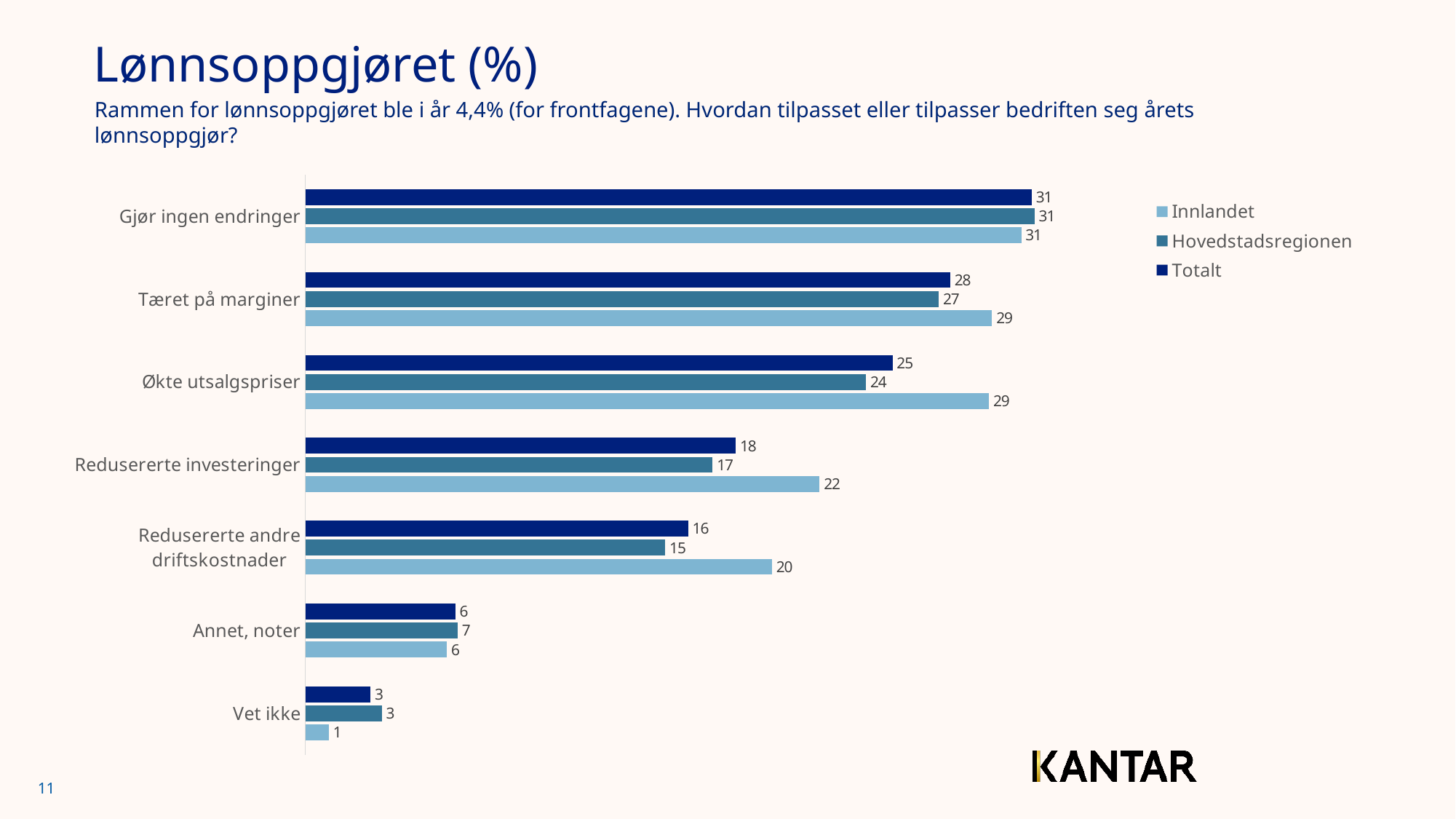
For Reduserte andre driftskostnader, which is larger: the Innlandet value or the Totalt value? Innlandet What is the Innlandet value for Vet ikke? 1 How many series does the legend list? 3 How many categories are shown on the chart? 7 Which series is shown in the darkest blue colour? Totalt Which category has the lowest Innlandet value? Vet ikke What is the difference between the Innlandet and Hovedstadsregionen values for Økte utsalgspriser? 5 What is the Hovedstadsregionen value for Tæret på marginer? 27 What kind of chart is shown on the slide? Bar chart What is the Totalt value for Økte utsalgspriser? 25 What is the Innlandet value for Reduserte investeringer? 22 Which category has the highest Totalt value? Gjør ingen endringer